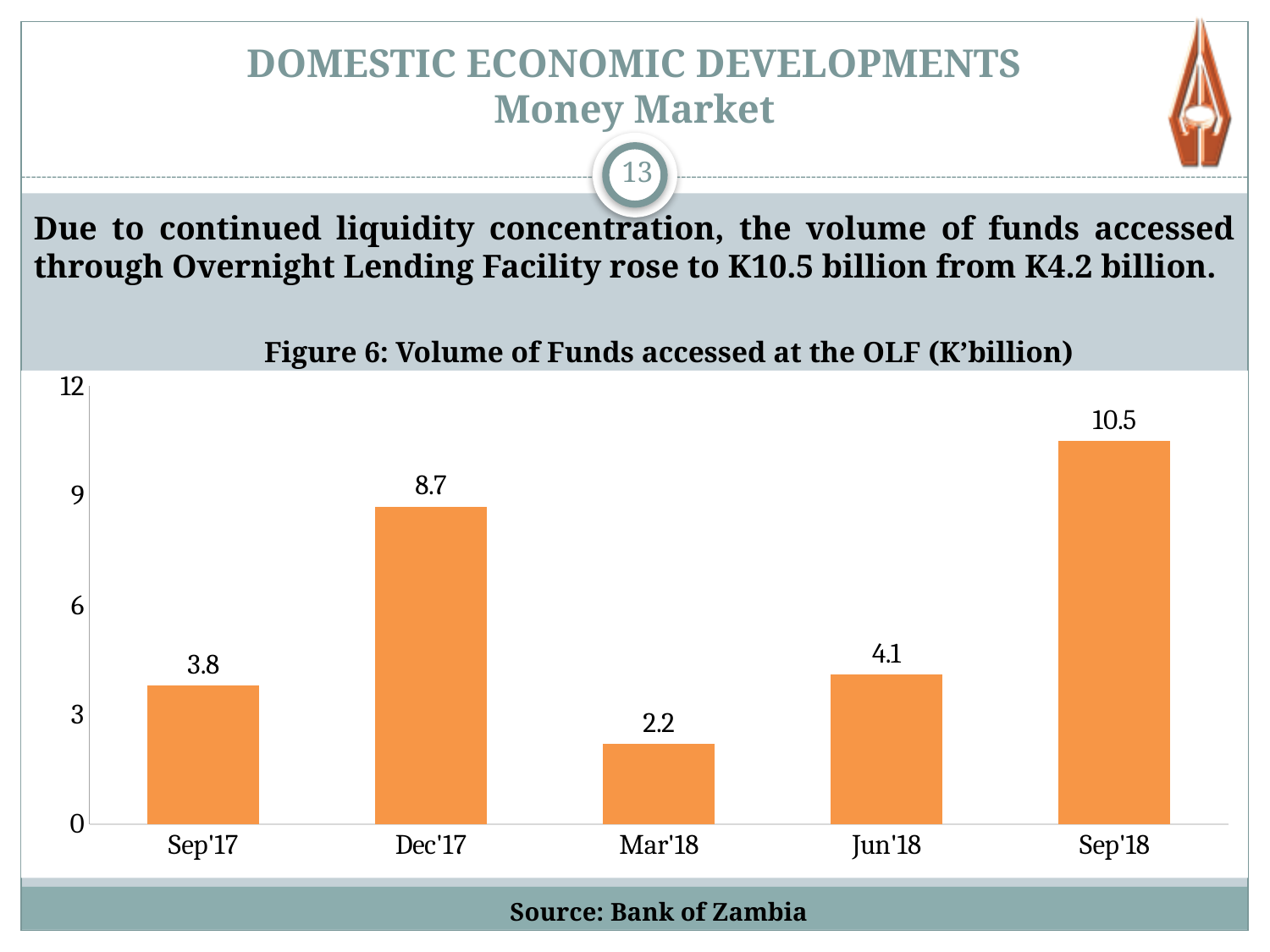
What is the volume of funds accessed at the OLF for Dec'17? 8.7 How many periods are shown on the x axis of the chart? 5 What is the title of the chart on the slide? Figure 6: Volume of Funds accessed at the OLF (K'billion) Which period has the highest volume of funds accessed at the OLF? Sep'18 What is the volume of funds accessed at the OLF for Jun'18? 4.1 What is the difference between the Sep'18 and Jun'18 values? 6.4 What kind of chart is Figure 6? Bar chart What is the volume of funds accessed at the OLF for Mar'18? 2.2 What is the volume of funds accessed at the OLF for Sep'17? 3.8 Is the value for Sep'18 greater or less than 9? greater Which is larger, the value for Dec'17 or the value for Jun'18? Dec'17 Which period has the lowest volume of funds accessed at the OLF? Mar'18